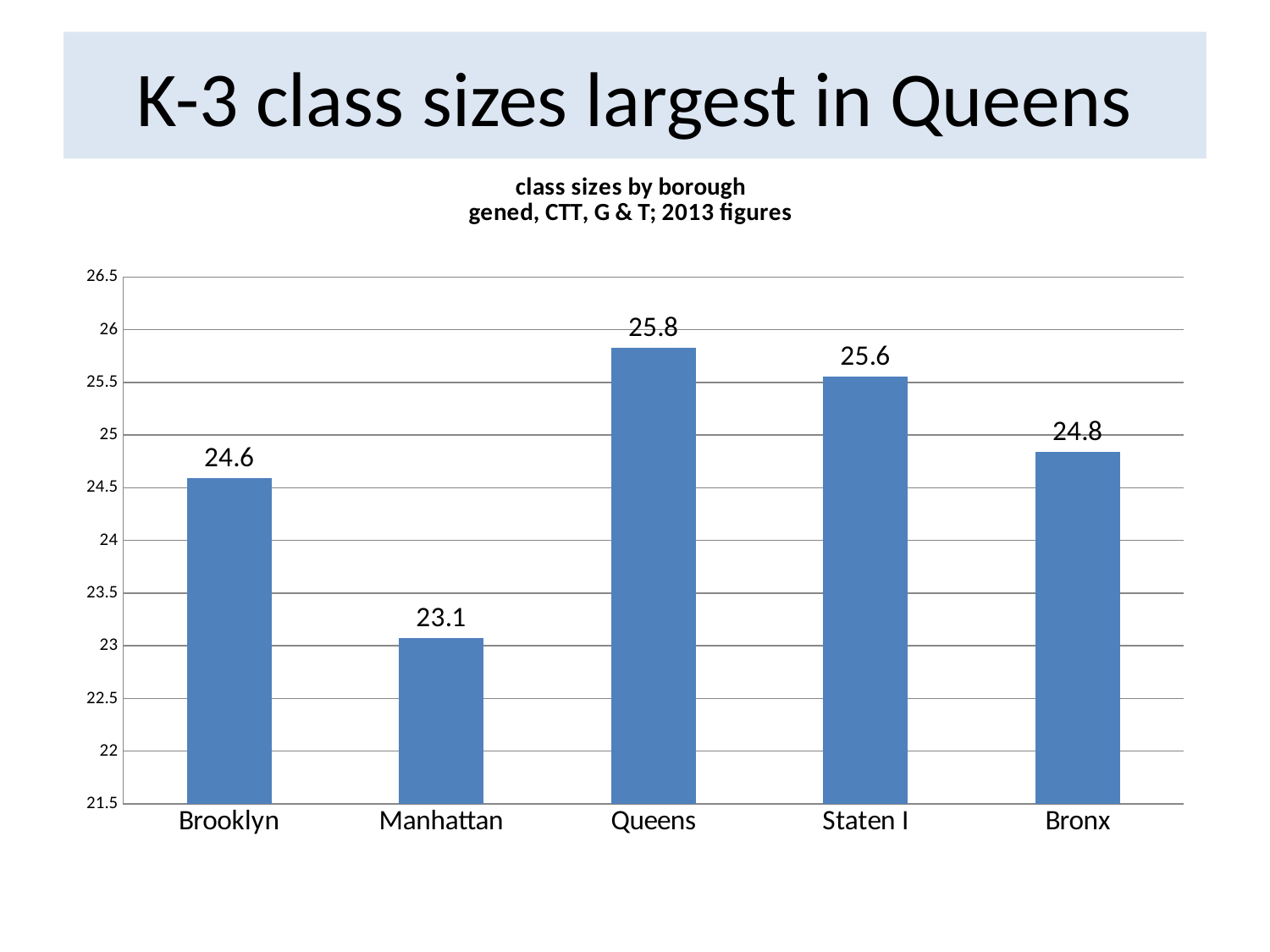
What is the class size value for Staten I? 25.6 How many boroughs are shown on the chart? 5 What is the difference between the class size values for Queens and Manhattan? 2.7 Which borough has the largest class size? Queens What is the class size value for Manhattan? 23.1 Is the value for Manhattan greater or less than 23.5? less What is the title of the chart? class sizes by borough gened, CTT, G & T; 2013 figures Which has a larger class size, Brooklyn or Bronx? Bronx What is the class size value for Brooklyn? 24.6 What is the difference between the class size values for Bronx and Brooklyn? 0.2 What kind of chart is shown on the slide? bar chart Which borough has the smallest class size? Manhattan